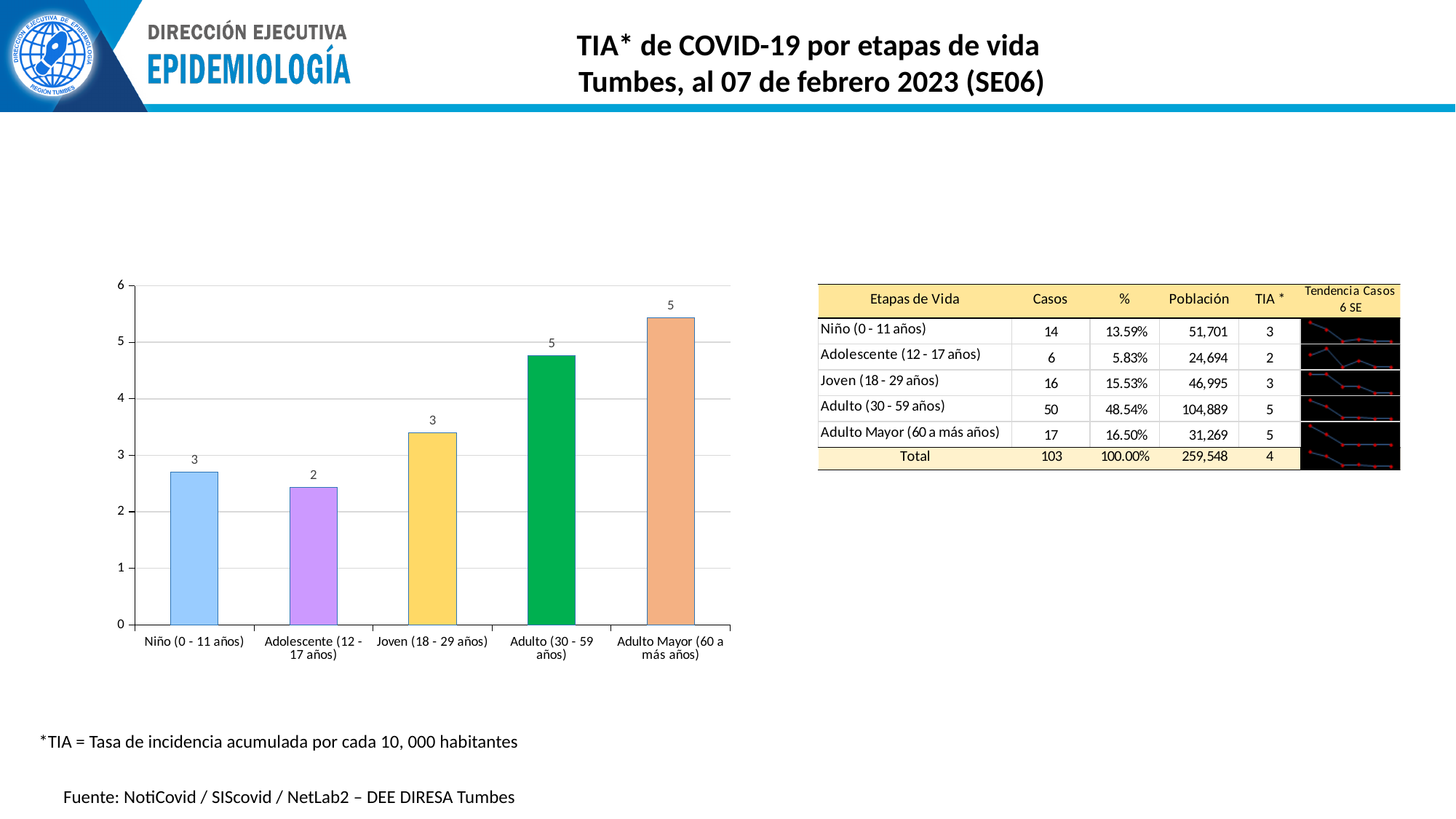
What kind of chart is shown on the slide? bar chart Which life stage has the highest bar in the chart? Adulto Mayor (60 a más años) What is the TIA value shown for Adolescente (12 - 17 años)? 2 Which life stage has the lowest bar in the chart? Adolescente (12 - 17 años) What is the TIA value shown for Adulto (30 - 59 años)? 5 What is the TIA value shown for Joven (18 - 29 años)? 3 Which bar is taller: Adulto (30 - 59 años) or Joven (18 - 29 años)? Adulto (30 - 59 años) What colour is the bar for Adulto (30 - 59 años)? green How many life-stage categories are plotted in the chart? 5 Is the bar for Adulto (30 - 59 años) greater or less than 4? greater Using the data labels, what is the difference between the value for Adulto Mayor (60 a más años) and the value for Adolescente (12 - 17 años)? 3 Is the bar for Niño (0 - 11 años) greater or less than 3? less